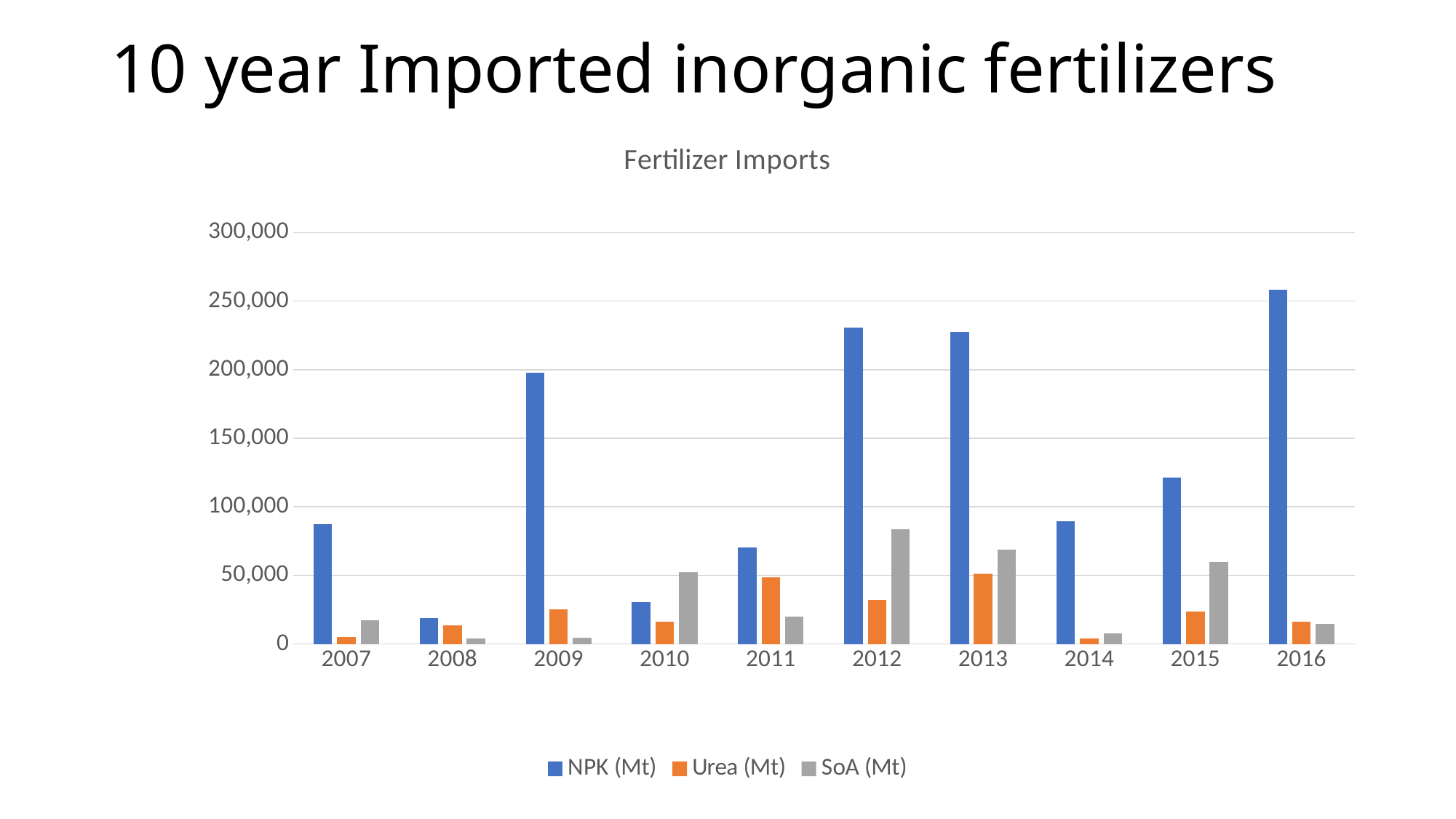
In 2010, which is larger, Urea (Mt) or SoA (Mt)? SoA (Mt) Is the SoA (Mt) value for 2012 greater or less than 50,000? greater In which year is the SoA (Mt) value highest? 2012 How many years are shown on the x axis? 10 What kind of chart is shown on the slide? Bar chart Is the NPK (Mt) value for 2016 greater or less than 250,000? greater Is the NPK (Mt) value for 2015 greater or less than 100,000? greater In which year is the NPK (Mt) value highest? 2016 In which year is the NPK (Mt) value lowest? 2008 What is the title of the chart? Fertilizer Imports Which is larger, the NPK (Mt) value for 2009 or for 2015? 2009 How many series does the legend list? 3